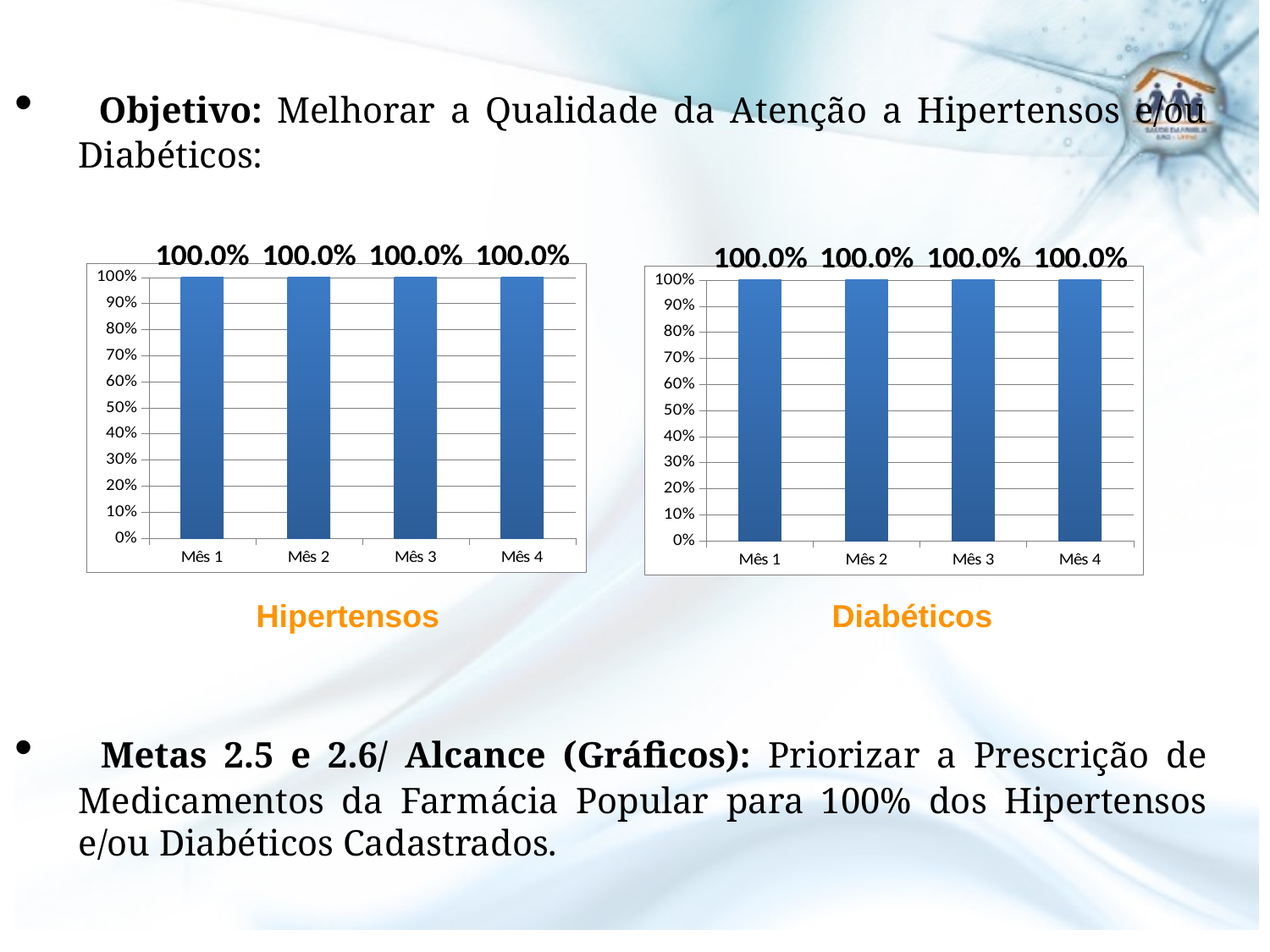
What kind of chart is the Hipertensos chart? Bar chart In the Hipertensos chart, do the values rise, fall or stay the same from Mês 1 to Mês 4? Stay the same In the Diabéticos chart, what is the value for Mês 2? 100.0% In the Diabéticos chart, is the value for Mês 3 greater or less than 90%? greater In the Hipertensos chart, what is the value for Mês 1? 100.0% How many categories (months) are shown in the Hipertensos chart? 4 In the Diabéticos chart, what is the value for Mês 4? 100.0% In the Hipertensos chart, what is the value for Mês 3? 100.0% In the Diabéticos chart, what is the difference between the values for Mês 1 and Mês 4? 0.0% How many bars are plotted in the Diabéticos chart? 4 What colour are the bars in the Hipertensos chart? Blue What is the label shown below the chart on the right? Diabéticos